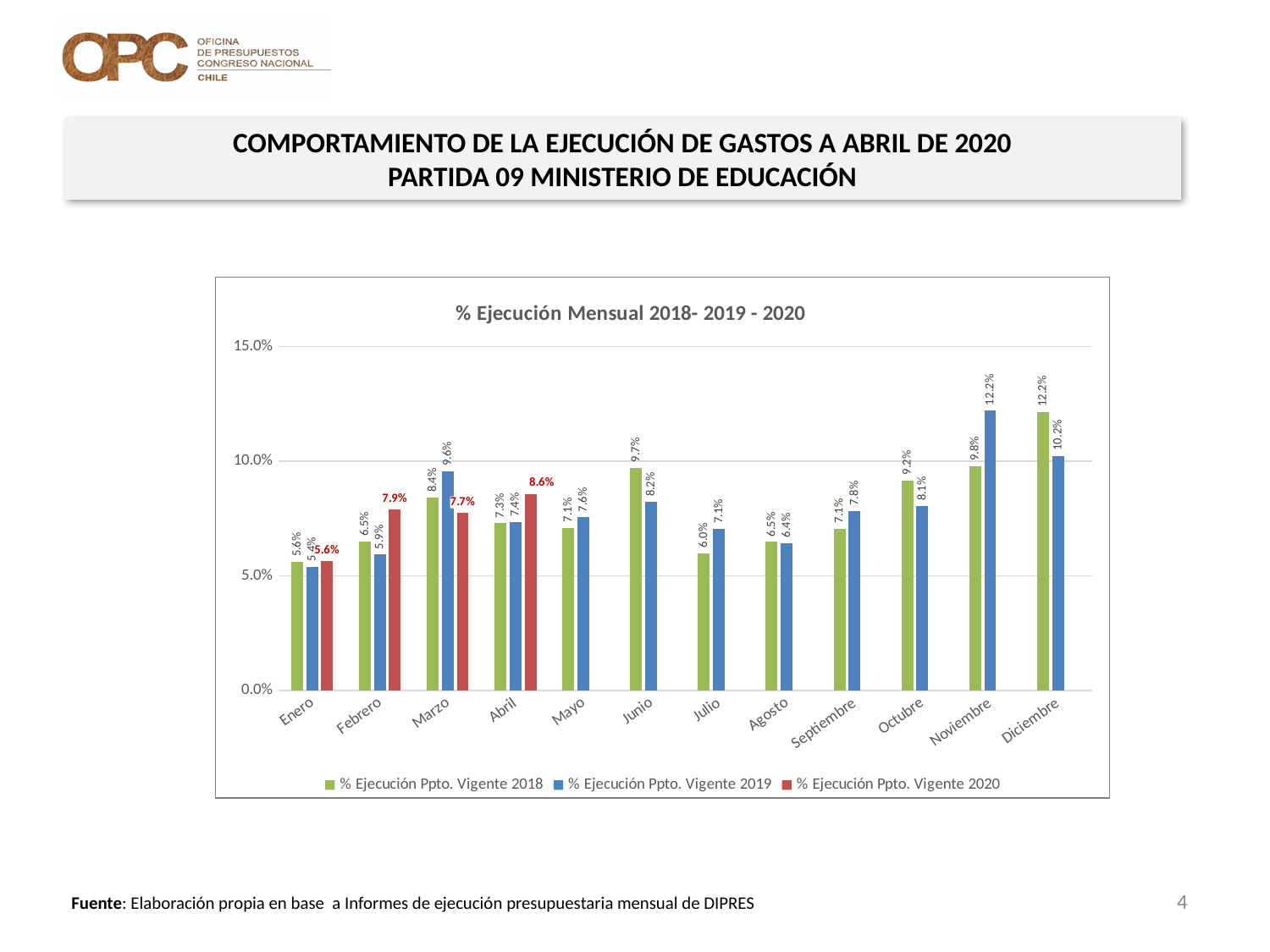
Is the value of % Ejecución Ppto. Vigente 2019 for Diciembre greater or less than 10.0%? greater What is the difference between the 2019 and 2018 values for Noviembre? 2.4% Which month has the highest value for % Ejecución Ppto. Vigente 2018? Diciembre What is the title of the chart? % Ejecución Mensual 2018- 2019 - 2020 For Febrero, which series has the larger value: % Ejecución Ppto. Vigente 2020 or % Ejecución Ppto. Vigente 2018? % Ejecución Ppto. Vigente 2020 What type of chart is shown on the slide? bar chart What is the value of % Ejecución Ppto. Vigente 2019 for Marzo? 9.6% What is the value of % Ejecución Ppto. Vigente 2018 for Junio? 9.7% How many series does the legend list? 3 Which month has the lowest value for % Ejecución Ppto. Vigente 2019? Enero How many months are shown on the x axis? 12 What is the value of % Ejecución Ppto. Vigente 2020 for Abril? 8.6%